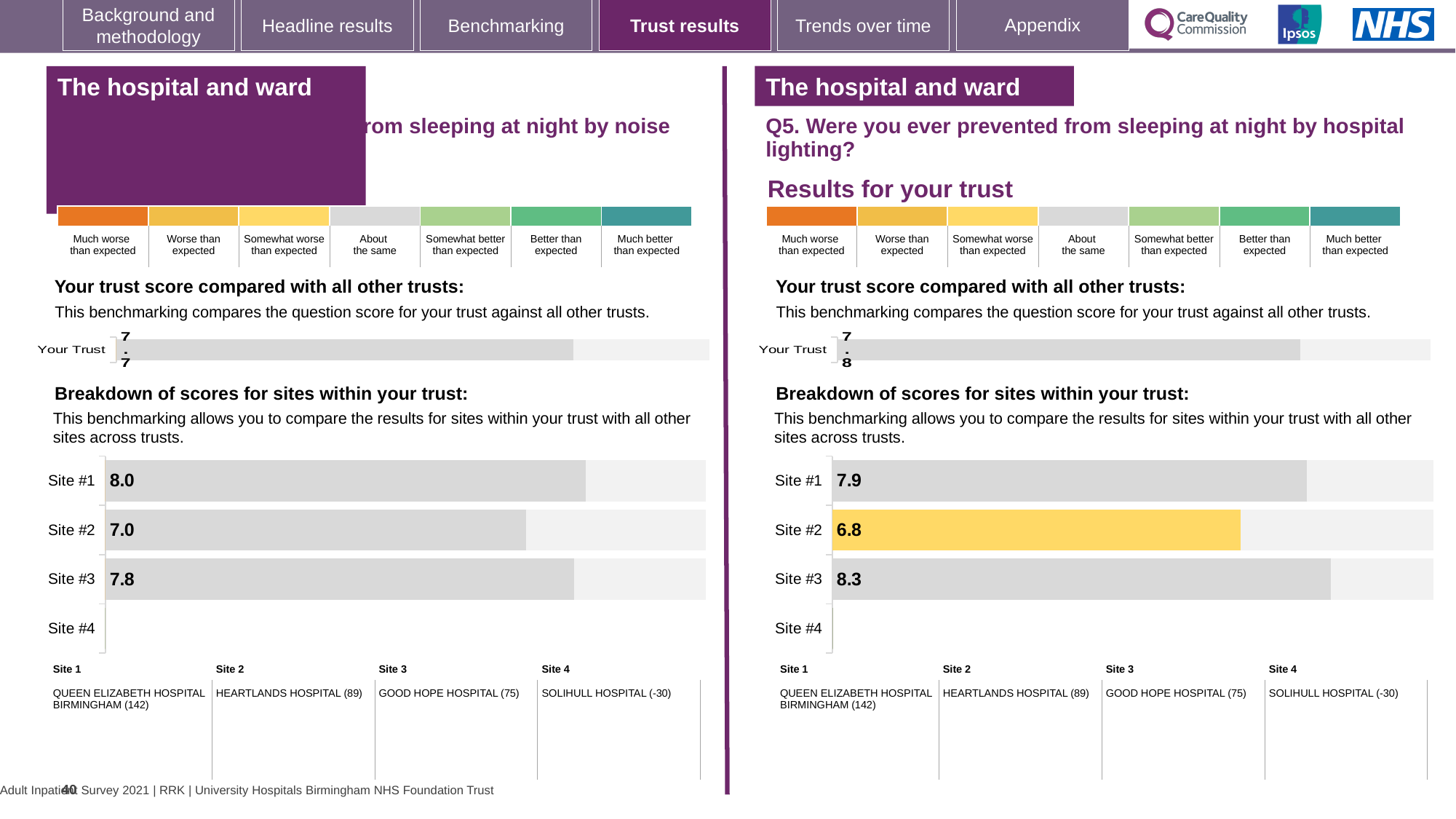
On the right-hand chart (Q5, hospital lighting), what is the difference between the Site #3 score and the Site #2 score? 1.5 On the right-hand chart (Q5, hospital lighting), what is the score for Site #1? 7.9 On the left-hand chart (sleeping at night by noise), which site has the highest score? Site #1 On the left-hand chart (sleeping at night by noise), what is the score for Site #1? 8.0 What type of chart is used to show the breakdown of scores for sites within the trust? Bar chart On the right-hand chart (Q5, hospital lighting), which site has the lowest score? Site #2 On the right-hand chart (Q5, hospital lighting), which site's bar is coloured yellow rather than grey? Site #2 On the right-hand chart (Q5, hospital lighting), is the score for Site #1 or Site #3 larger? Site #3 On the right-hand chart (Q5, hospital lighting), what is the score for Site #3? 8.3 On the right-hand chart (Q5, hospital lighting), what is the score for Site #2? 6.8 On the left-hand chart (sleeping at night by noise), what is the difference between the Site #1 score and the Site #2 score? 1.0 On the left-hand chart (sleeping at night by noise), what is the score for Site #2? 7.0